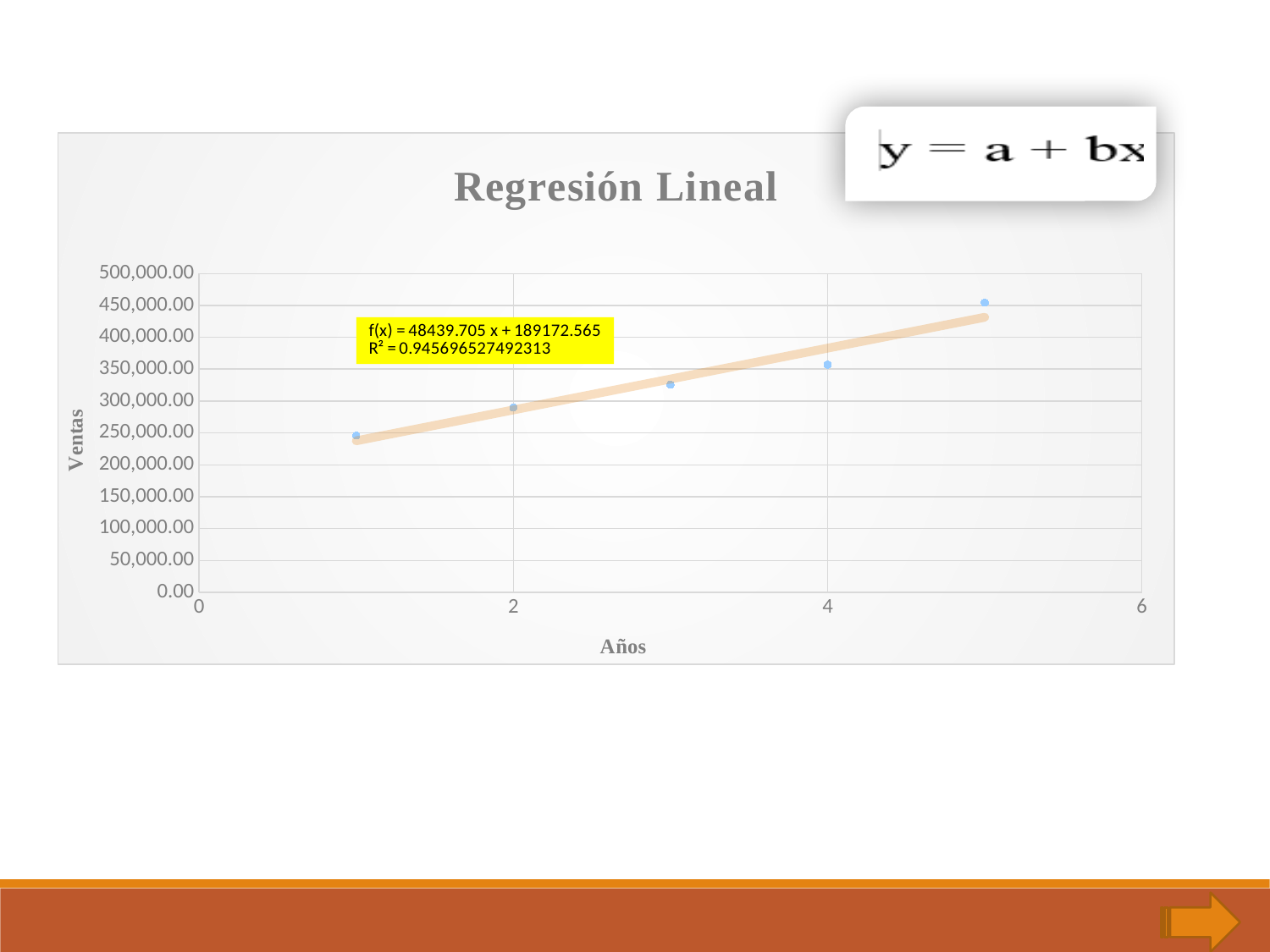
How many data points are plotted on the chart? 5 Which has the larger sales value, year 2 or year 4? year 4 What kind of chart is shown on the slide? scatter chart Is the sales value at year 4 greater or less than 400,000.00? less What is the trendline equation shown on the chart? f(x) = 48439.705 x + 189172.565 Is the sales value at year 5 greater or less than 400,000.00? greater Is the sales value at year 1 greater or less than 200,000.00? greater Do the plotted values rise or fall as the years increase along the x axis? rise At which year (x value) is the plotted sales value lowest? 1 What is the title of the chart? Regresión Lineal At which year (x value) is the plotted sales value highest? 5